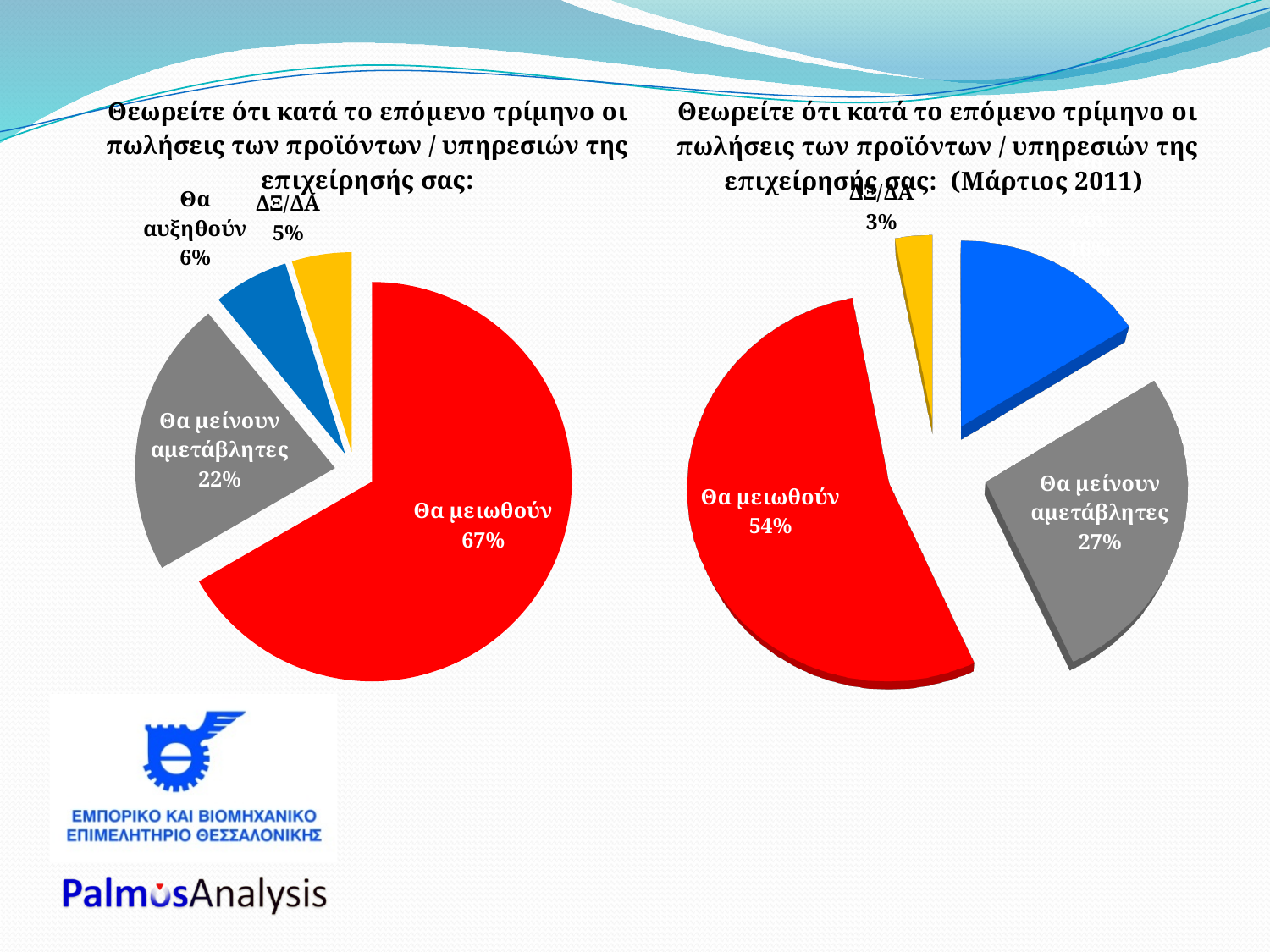
In the left pie chart, which category has the largest slice? Θα μειωθούν In the right pie chart (Μάρτιος 2011), what share is labelled for 'Θα μείνουν αμετάβλητες'? 27% In the left pie chart, how many slices are there? 4 In the left pie chart, what share is labelled for 'ΔΞ/ΔΑ'? 5% In the right pie chart (Μάρτιος 2011), what share is labelled for 'Θα μειωθούν'? 54% In the left pie chart, which category has the smallest slice? ΔΞ/ΔΑ What type of chart is shown on the left side of the slide? Pie chart What is the difference between the 'Θα μειωθούν' share in the left pie chart and in the right pie chart (Μάρτιος 2011)? 13 percentage points